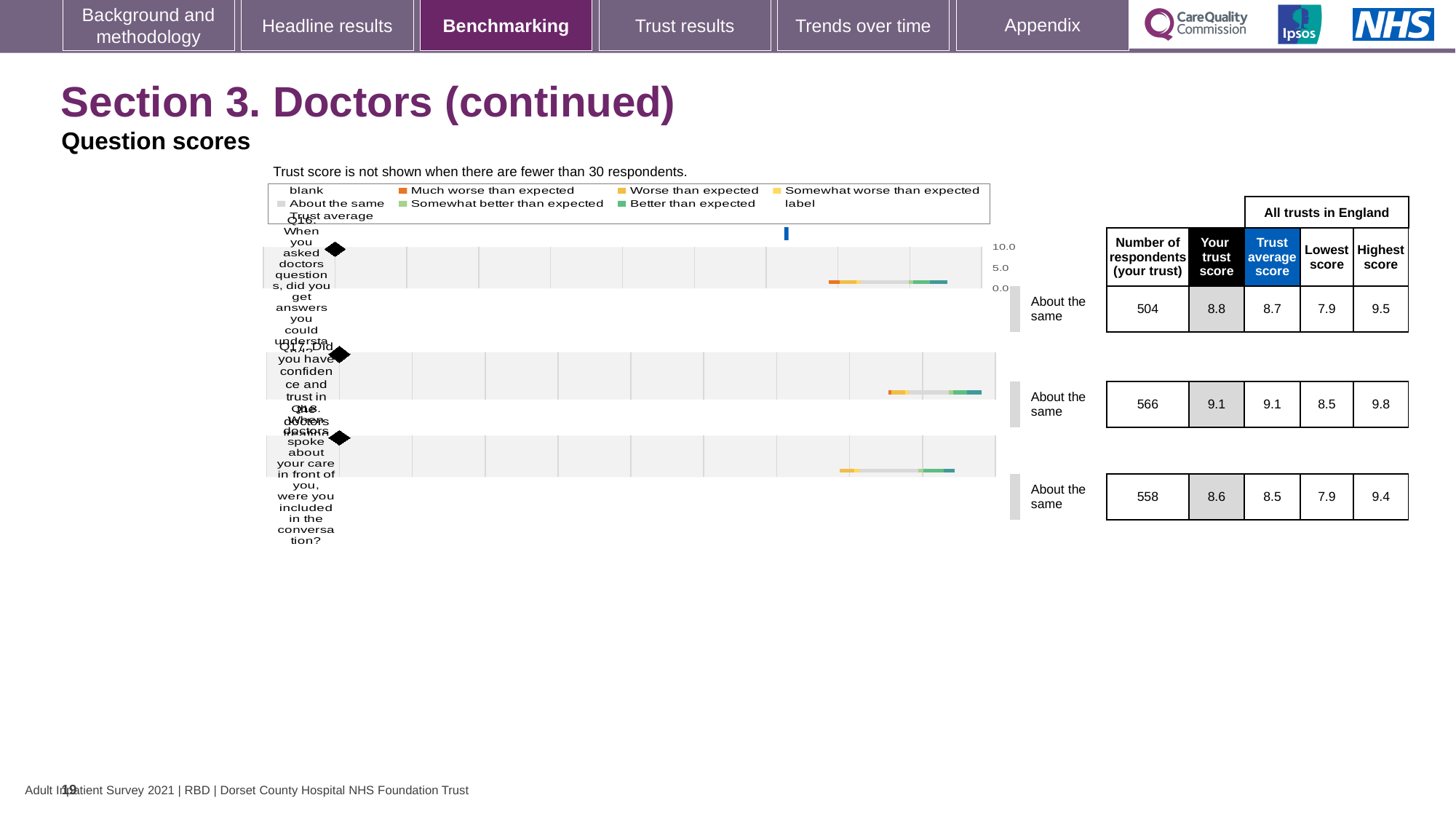
What is the highest score among all trusts in England for Q17? 9.8 How many questions are plotted on the chart? 3 Which question has the lowest 'Your trust score'? Q18 How many respondents from the trust answered Q17 (Did you have confidence and trust in the doctors treating you?)? 566 Which is larger for Q16: the trust's own score or the trust average score for all trusts in England? Your trust score What is the trust score for Q16 (When you asked doctors questions, did you get answers you could understand?)? 8.8 What kind of chart is used to show the question scores? Bar chart What is the difference between the highest score and the lowest score for Q17? 1.3 What benchmark category is shown for all three questions? About the same Which question has the highest 'Your trust score'? Q17 Is the trust score for Q18 greater or less than 5.0? greater What is the trust average score for all trusts in England for Q18 (When doctors spoke about your care in front of you, were you included in the conversation?)? 8.5